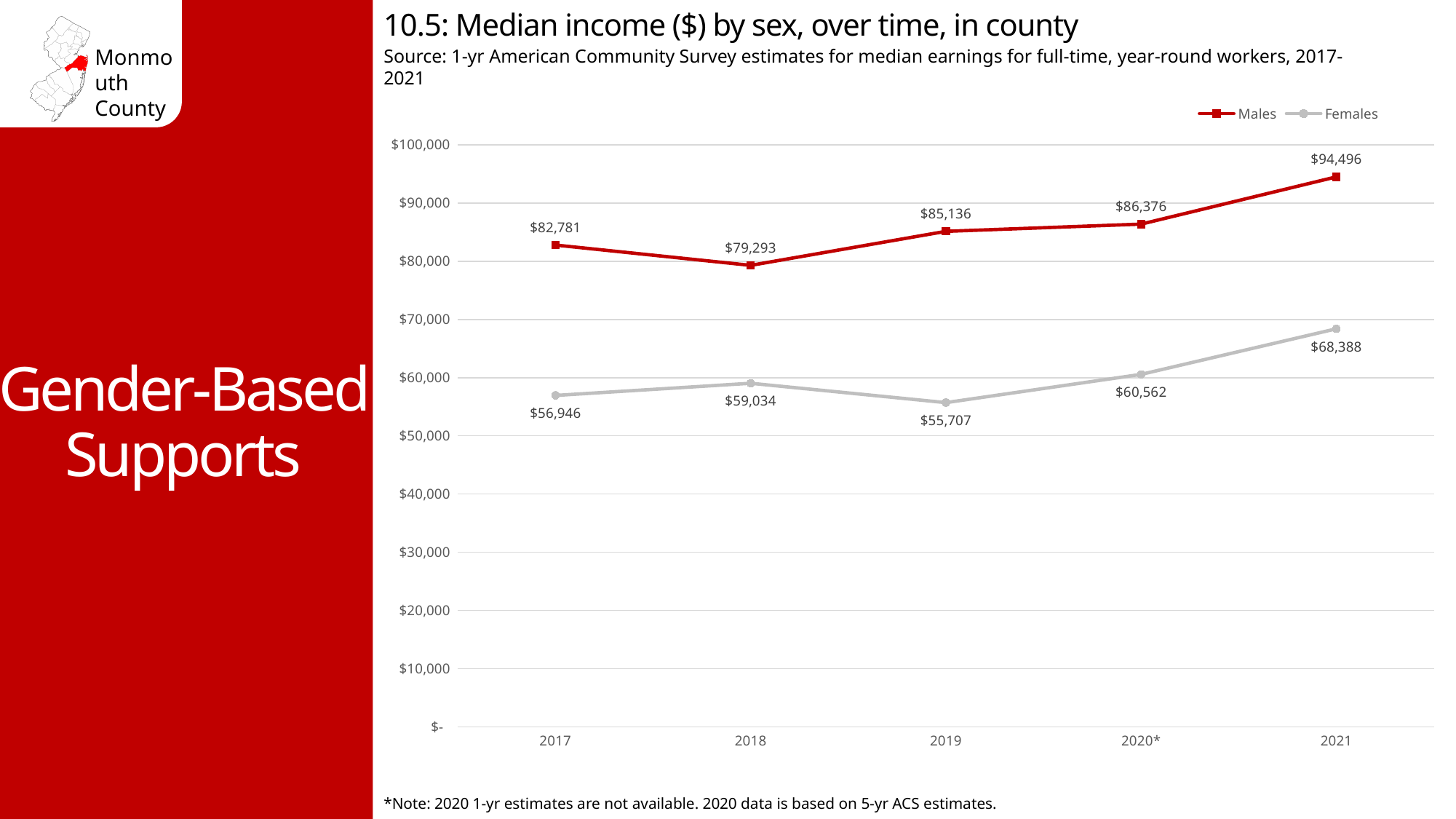
In which year was the median income for females lowest? 2019 What was the median income for males in 2021? $94,496 How many years are shown on the x axis? 5 Is the median income for females in 2020* greater or less than $70,000? less In which year was the median income for males highest? 2021 Which was higher in 2017: the median income for males or for females? Males Which series is drawn in red? Males What is the difference between male and female median income in 2021? $26,108 What was the median income for males in 2018? $79,293 What kind of chart is shown on the slide? Line chart What was the median income for females in 2019? $55,707 How many series does the legend list? 2